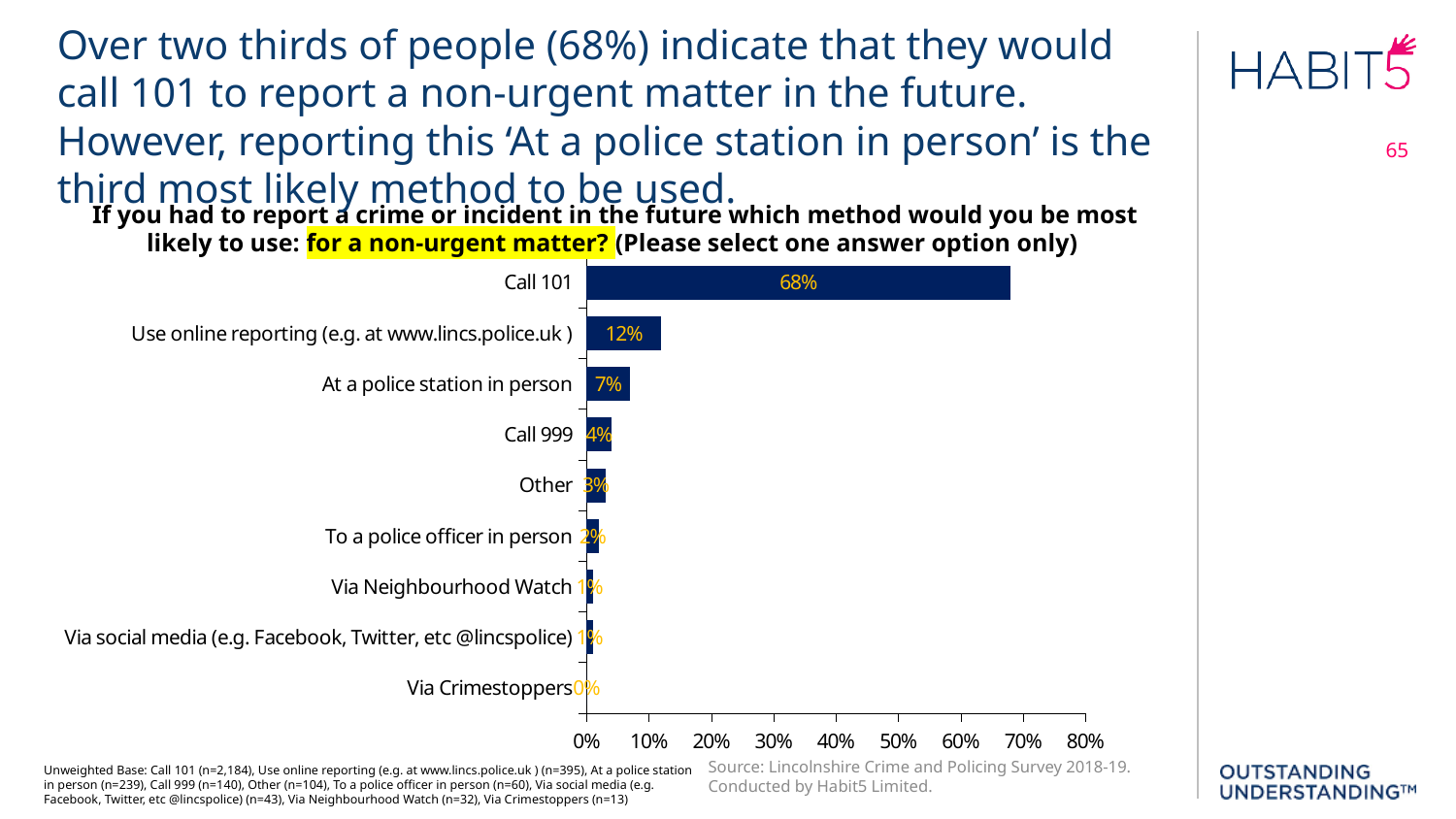
Which is larger: the value for 'At a police station in person' or the value for 'Call 999'? At a police station in person What kind of chart is shown on the slide? Bar chart What is the value for 'Use online reporting (e.g. at www.lincs.police.uk )'? 12% What is the value for 'At a police station in person'? 7% What is the difference between the values for 'Call 101' and 'Use online reporting (e.g. at www.lincs.police.uk )'? 56% Is the value for 'Call 101' greater or less than 60%? greater What is the maximum value shown on the horizontal axis? 80% Which method has the lowest percentage? Via Crimestoppers Which method has the highest percentage? Call 101 How many reporting methods are shown in the chart? 9 What percentage of people would call 101 to report a non-urgent matter? 68% What is the value for 'Call 999'? 4%